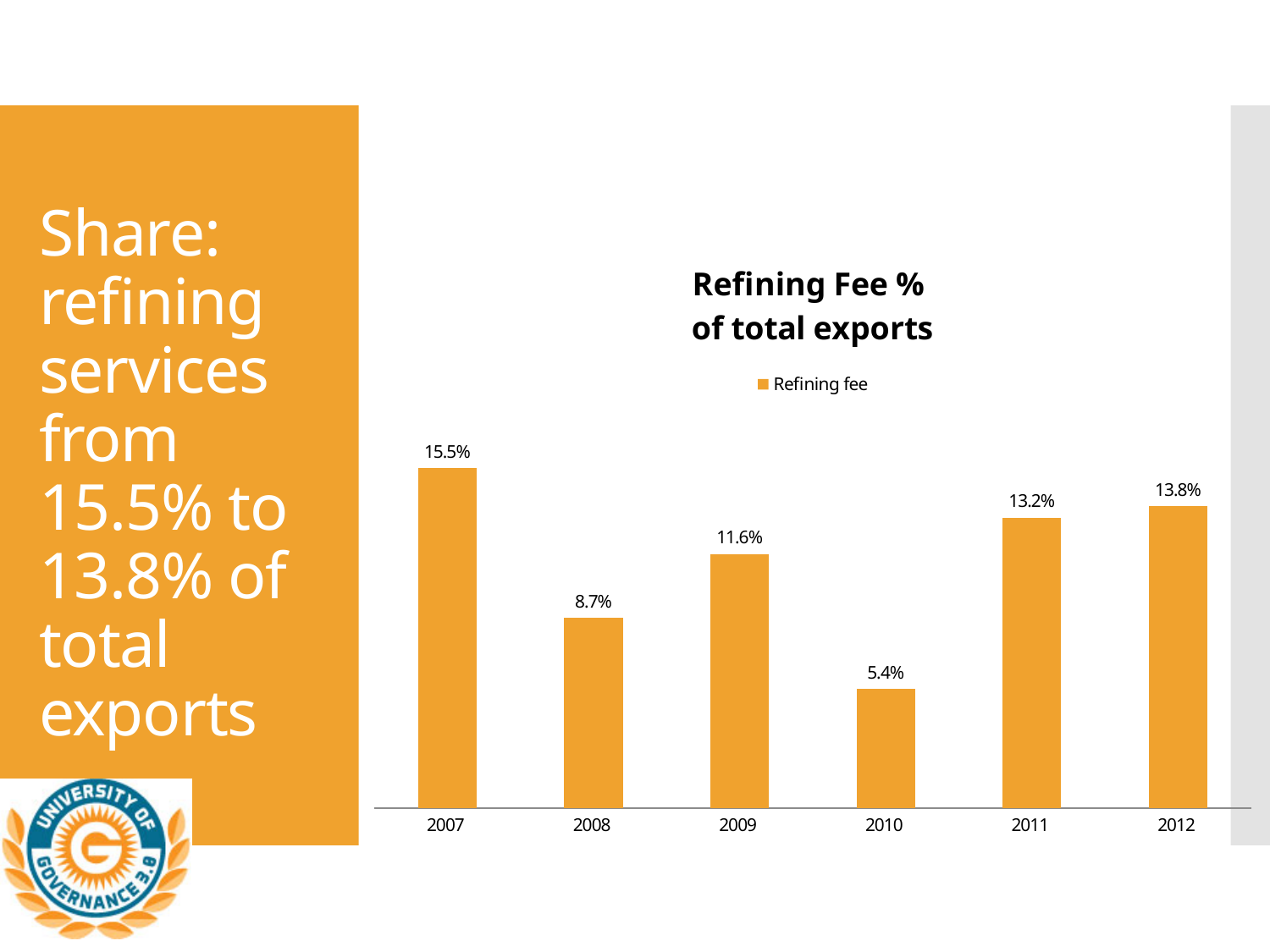
Which year has a larger refining fee share of total exports, 2011 or 2009? 2011 What kind of chart is shown on the slide? Bar chart How many series does the legend list? 1 What is the refining fee as a percentage of total exports in 2007? 15.5% How many years are shown on the chart? 6 What is the difference between the refining fee share in 2007 and in 2012? 1.7% What is the difference between the refining fee share in 2009 and in 2008? 2.9% What is the refining fee as a percentage of total exports in 2012? 13.8% What is the title of the chart? Refining Fee % of total exports What is the refining fee as a percentage of total exports in 2010? 5.4% Which year has the lowest refining fee share of total exports? 2010 Which year has the highest refining fee share of total exports? 2007